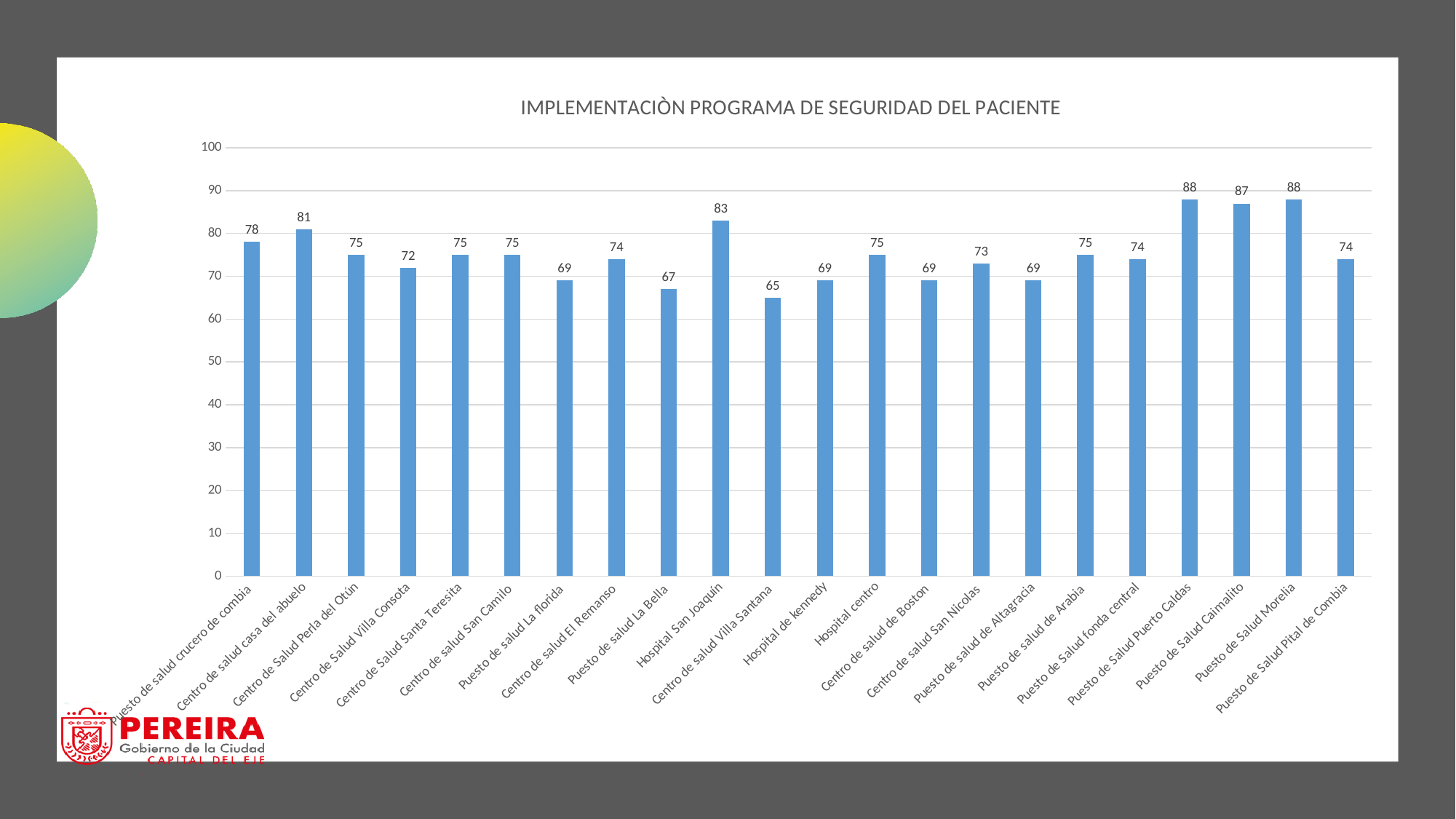
What is the value for Hospital San Joaquín? 83 Which is larger, the value for Hospital San Joaquín or the value for Centro de salud San Nicolas? Hospital San Joaquín What is the title of the chart? IMPLEMENTACIÒN PROGRAMA DE SEGURIDAD DEL PACIENTE What is the value for Puesto de Salud Caimalito? 87 How many categories are shown on the x axis? 22 What is the difference between the values for Centro de salud casa del abuelo and Puesto de salud crucero de combia? 3 What is the value for Centro de salud Villa Santana? 65 What kind of chart is shown on the slide? Bar chart Which category has the lowest value? Centro de salud Villa Santana What is the difference between the values for Puesto de Salud Puerto Caldas and Puesto de salud La Bella? 21 What is the value for Centro de Salud Villa Consota? 72 Is the value for Puesto de Salud Morelia greater or less than 80? greater